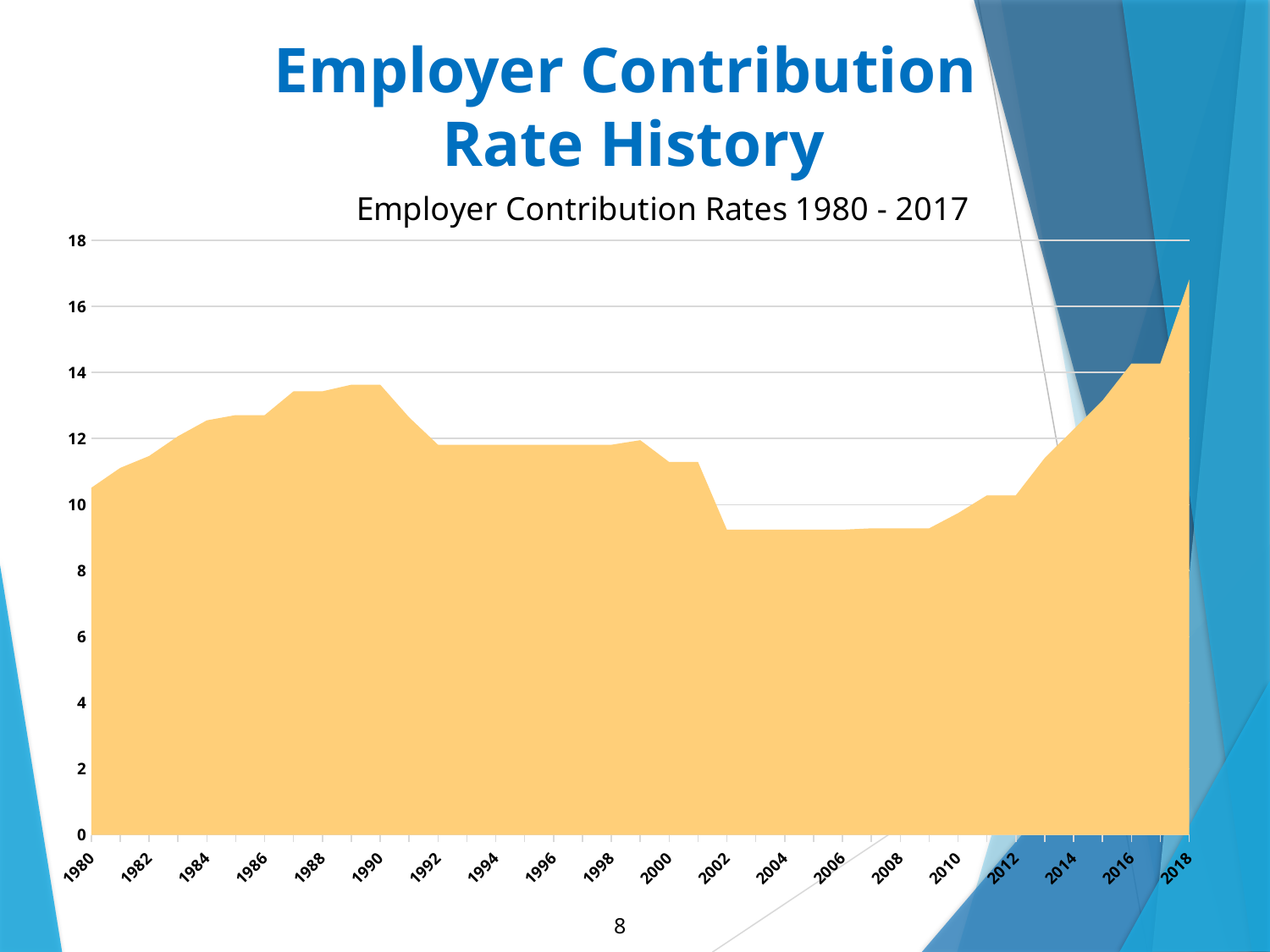
Do the values rise or fall between 1990 and 2002? fall Is the value for 2016 greater or less than 12? greater Which year label on the x axis corresponds to the highest value in the chart? 2018 Do the values rise or fall between 2008 and 2018? rise What is the title of the chart? Employer Contribution Rates 1980 - 2017 What kind of chart is shown on the slide? area chart Which is larger, the value for 1990 or the value for 2004? 1990 Is the value for 1980 greater or less than 10? greater Is the value for 2018 greater or less than 16? greater